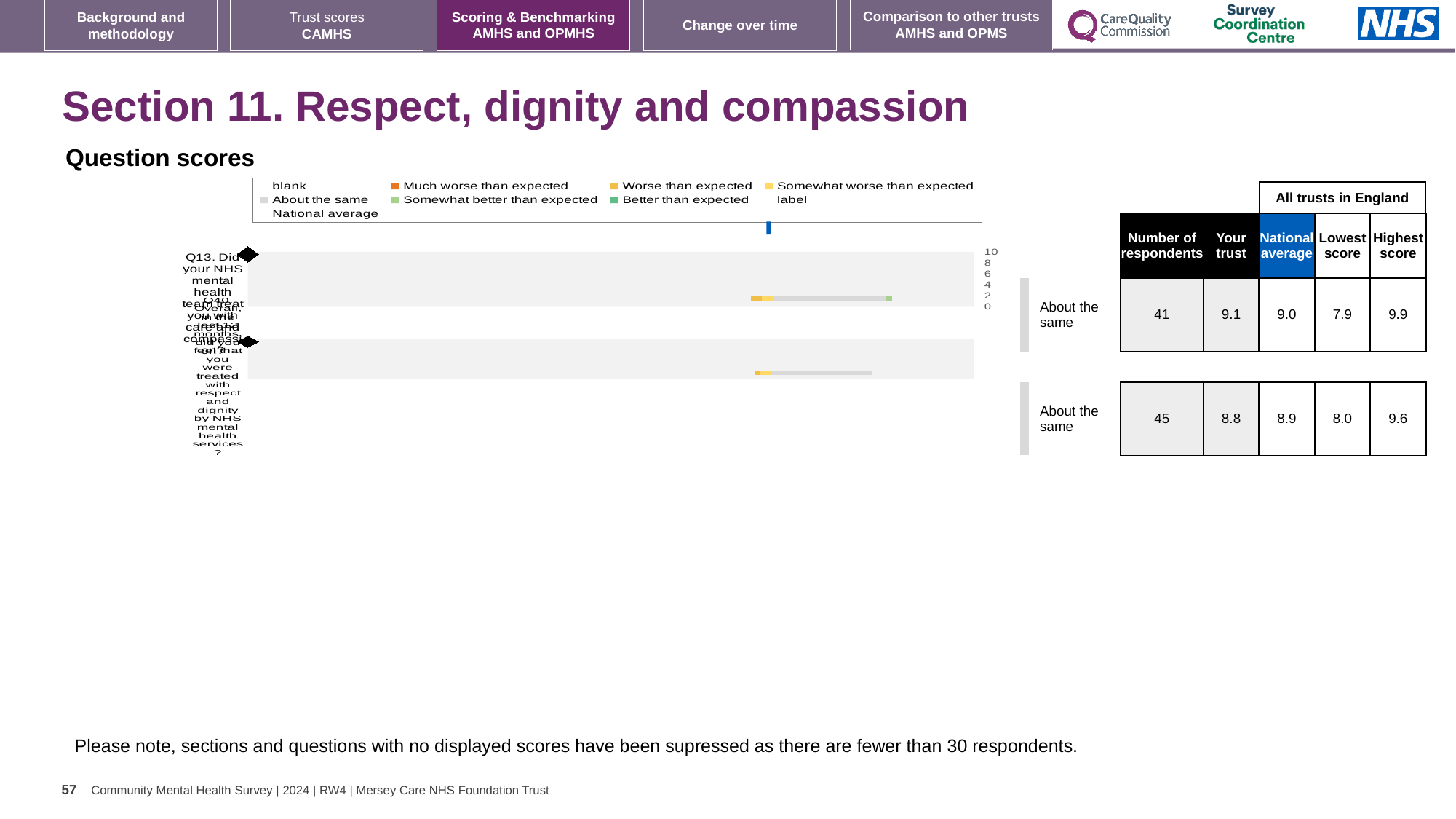
In the legend of the question scores chart, what colour represents 'Better than expected'? green What is the lowest score for Q13 shown in the table? 7.9 Which question has the higher 'Highest score' in the table, Q13 or Q10? Q13 What benchmark category is shown next to the chart for Q13? About the same How many questions are plotted in the question scores chart? 2 How many entries does the legend of the question scores chart list? 9 According to the table beside the chart, how many respondents answered Q10? 45 What is the national average score for Q10 shown in the table? 8.9 According to the table beside the chart, what is the 'Your trust' score for Q13? 9.1 What is the difference between the highest score and the lowest score for Q13 in the table? 2.0 What kind of chart is used to show the question scores on this slide? bar chart Which question has the higher 'Your trust' score in the table, Q13 or Q10? Q13